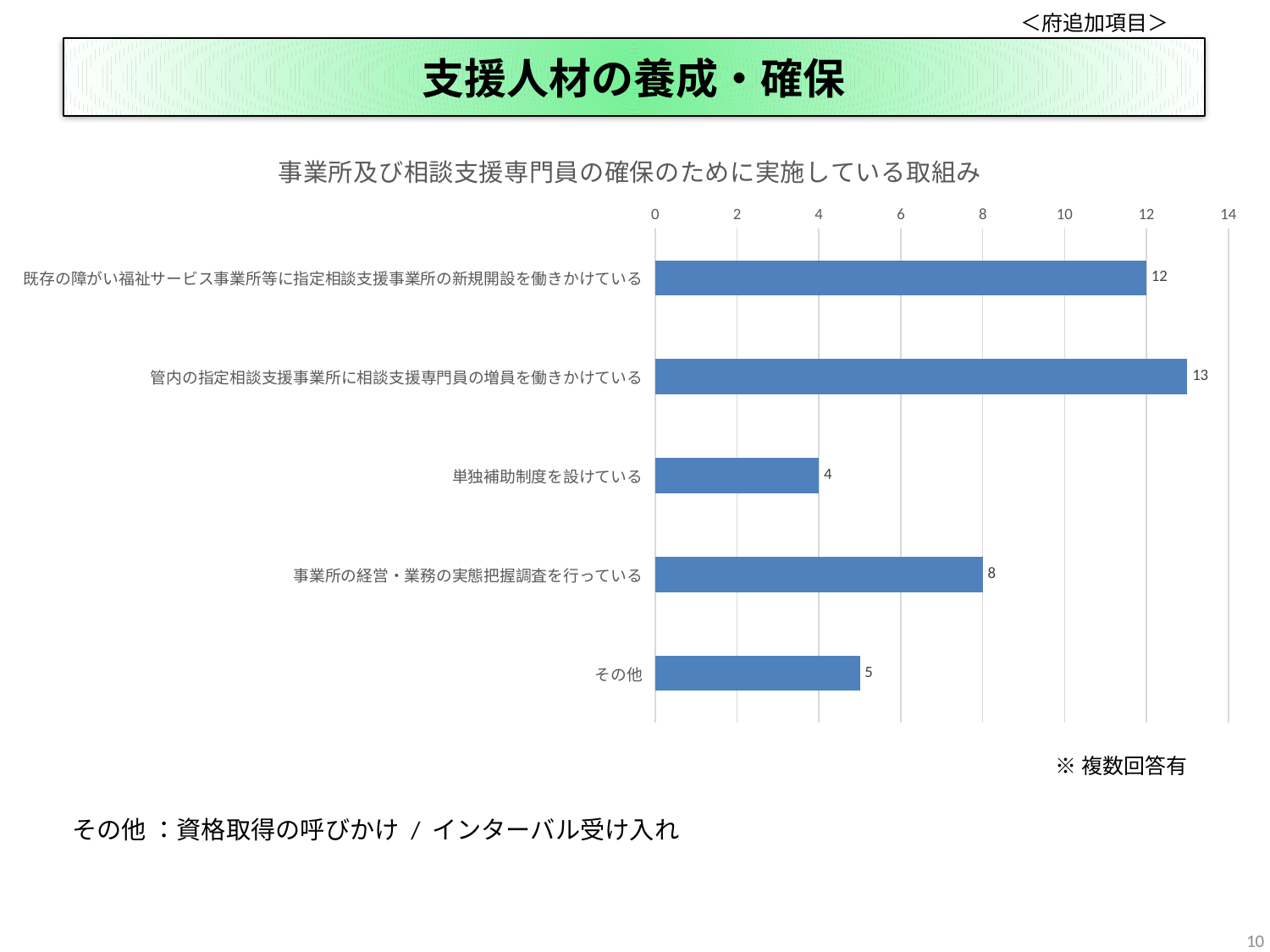
Is the value for 事業所の経営・業務の実態把握調査を行っている greater or less than 10? less What is the value for 管内の指定相談支援事業所に相談支援専門員の増員を働きかけている? 13 What is the difference between the values for 既存の障がい福祉サービス事業所等に指定相談支援事業所の新規開設を働きかけている and 事業所の経営・業務の実態把握調査を行っている? 4 What is the value for 単独補助制度を設けている? 4 What is the title of the chart? 事業所及び相談支援専門員の確保のために実施している取組み How many categories are shown in the chart? 5 What kind of chart is shown on the slide? bar chart What is the value for 事業所の経営・業務の実態把握調査を行っている? 8 Which category has the lowest value? 単独補助制度を設けている Which category has the highest value? 管内の指定相談支援事業所に相談支援専門員の増員を働きかけている Which is larger: the value for その他 or the value for 単独補助制度を設けている? その他 What is the value for その他? 5